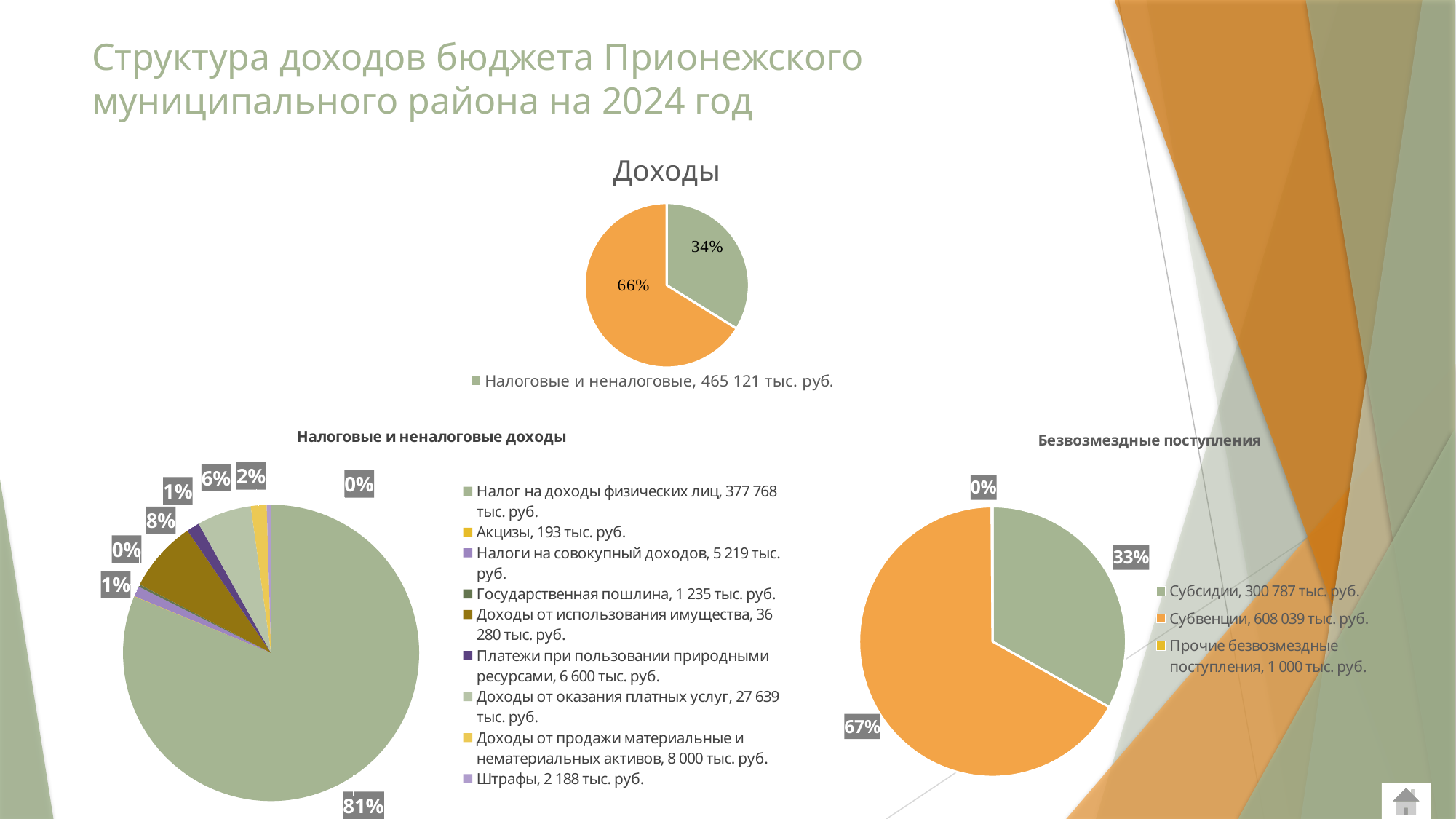
In the "Безвозмездные поступления" chart, which category is the largest? Субвенции How many entries does the legend of the "Безвозмездные поступления" chart list? 3 In the "Безвозмездные поступления" chart, what is the difference between "Субвенции" and "Субсидии"? 307 252 тыс. руб. In the "Безвозмездные поступления" chart, what share of the pie is "Субсидии"? 33% In the "Безвозмездные поступления" chart, what is the value for "Субвенции"? 608 039 тыс. руб. In the "Безвозмездные поступления" chart, which category is the smallest? Прочие безвозмездные поступления How many entries does the legend of the "Налоговые и неналоговые доходы" chart list? 9 In the "Налоговые и неналоговые доходы" chart, which is larger: "Доходы от использования имущества" or "Доходы от оказания платных услуг"? Доходы от использования имущества In the "Безвозмездные поступления" chart, what share of the pie is "Субвенции"? 67% In the "Доходы" chart, what share of the pie is "Налоговые и неналоговые"? 34% What kind of chart is the "Доходы" chart? pie chart